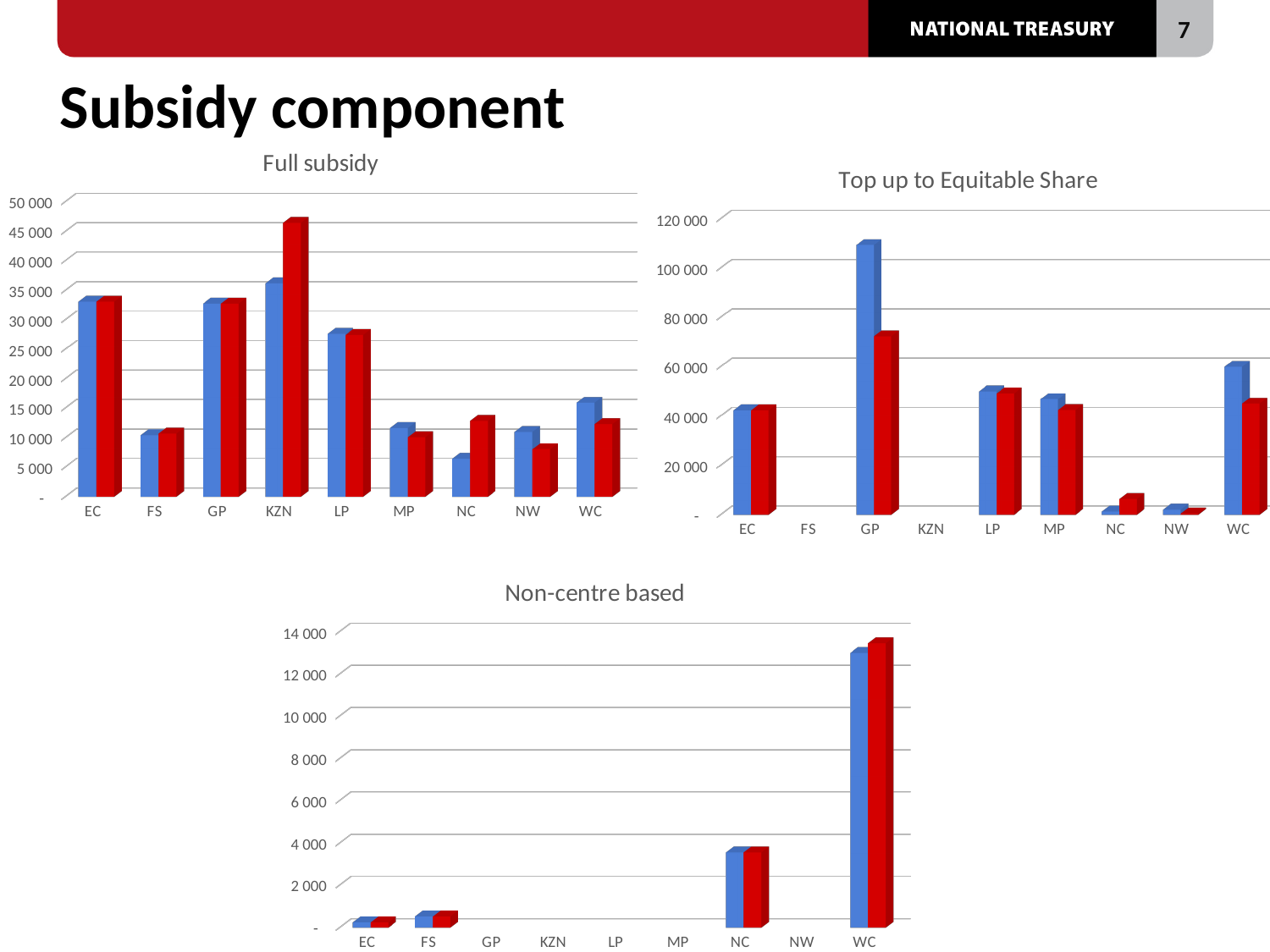
In the "Non-centre based" chart, is the value of the blue bar for NC greater or less than 4 000? less What kind of chart is the "Full subsidy" chart? bar chart What is the title of the chart at the bottom of the slide? Non-centre based In the "Top up to Equitable Share" chart, is the value of the blue bar for GP greater or less than 100 000? greater In the "Full subsidy" chart, is the value of the blue bar for EC greater or less than 30 000? greater In the "Top up to Equitable Share" chart, which category has the tallest bar? GP In the "Full subsidy" chart, which has the larger blue bar, GP or LP? GP In the "Full subsidy" chart, which category has the tallest bar? KZN How many categories are shown on the x axis of the "Full subsidy" chart? 9 In the "Non-centre based" chart, which category has the tallest bar? WC